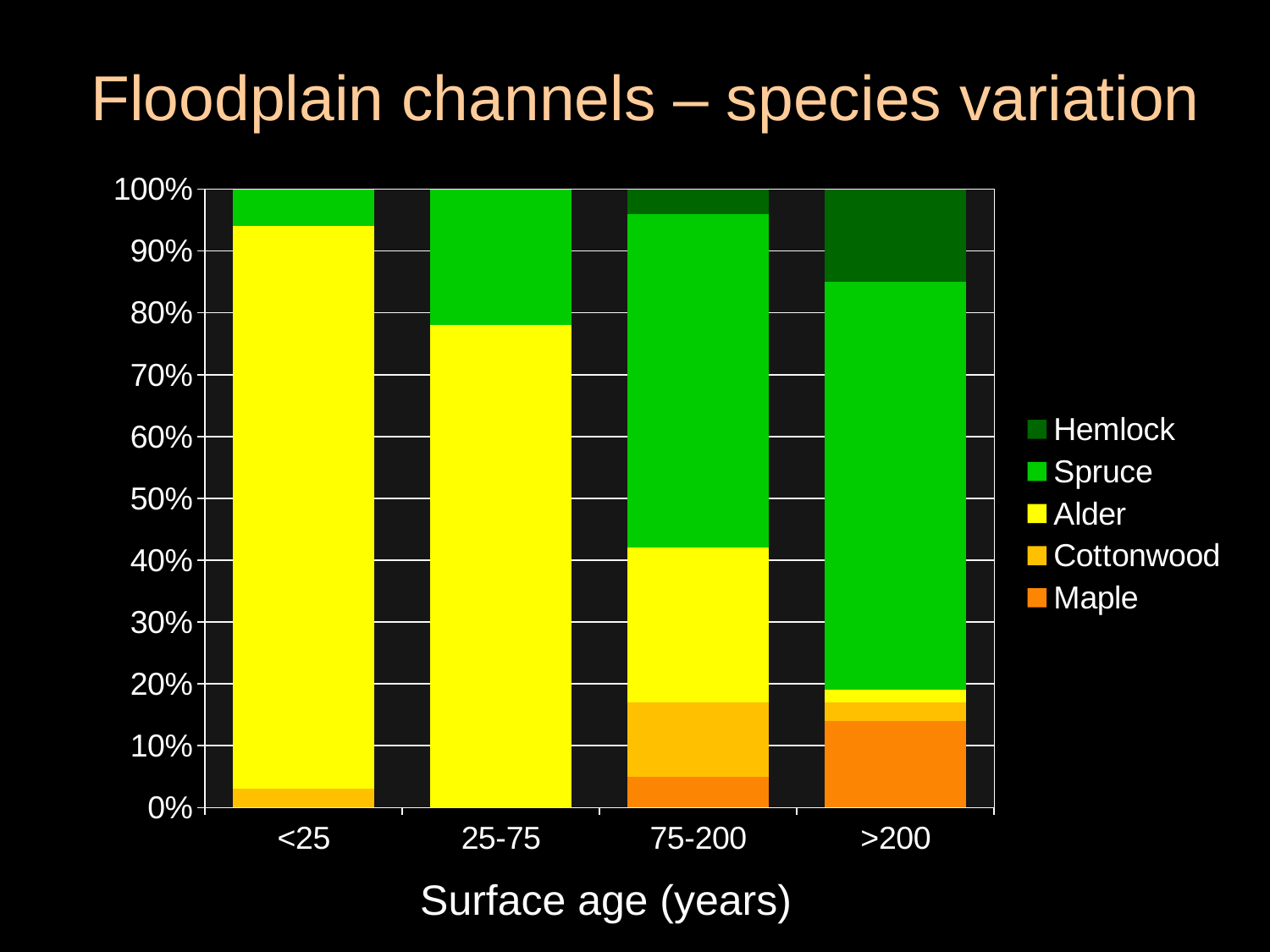
What is the label of the x axis? Surface age (years) Which is larger, the Spruce share in the <25 bar or the Spruce share in the 25-75 bar? 25-75 Is the Hemlock share in the >200 bar greater or less than 20%? less How many species does the legend list? 5 Does the Alder share rise or fall as surface age increases? fall Which surface age category has the largest Alder share? <25 Which surface age category has the smallest Alder share? >200 Is the Alder share in the <25 bar greater or less than 80%? greater What kind of chart is shown on the slide? Stacked bar chart What is the title of the slide? Floodplain channels – species variation How many surface age categories are shown on the x axis? 4 Which surface age category has the largest Spruce share? >200